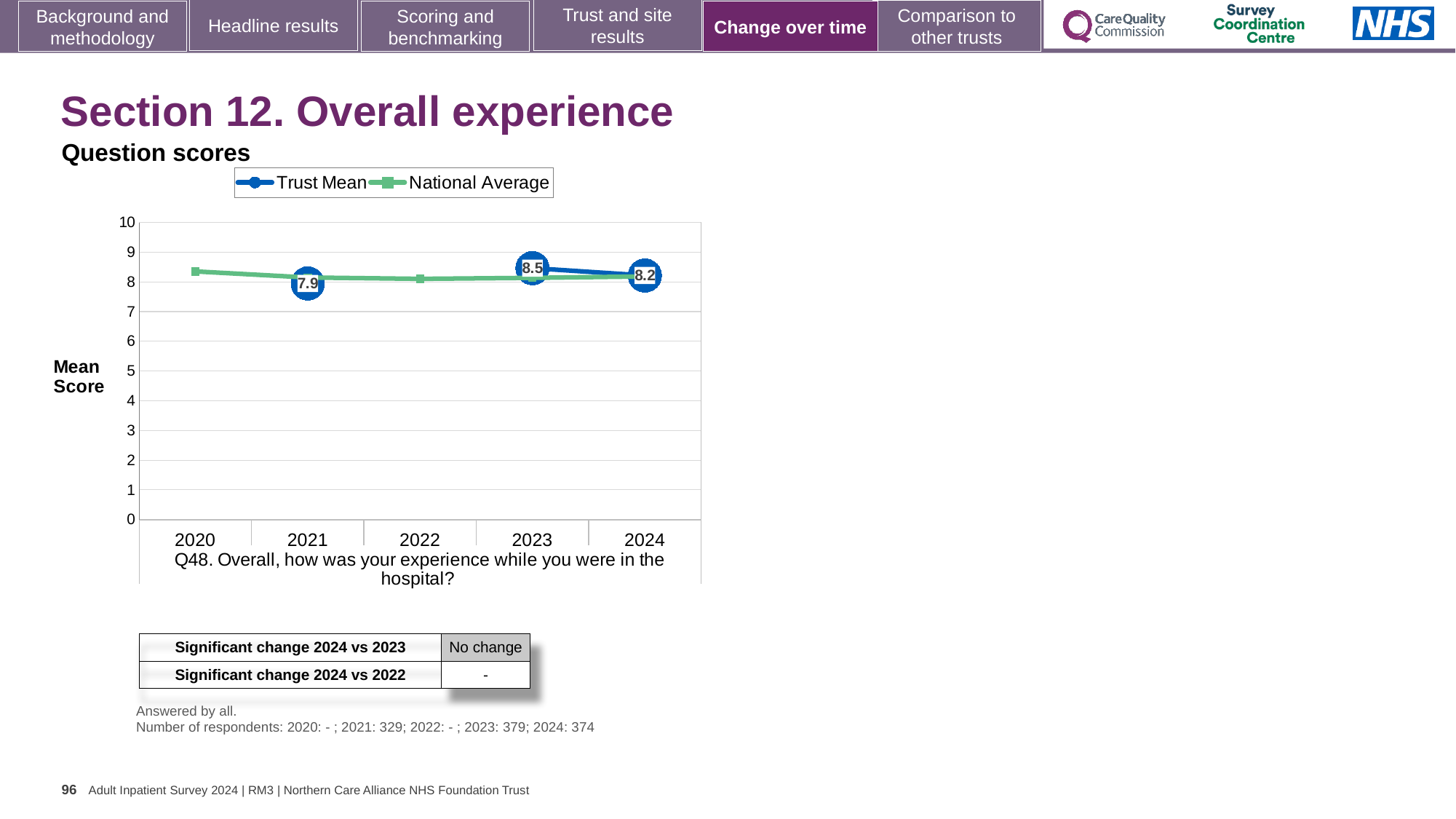
What is the Trust Mean value for 2023? 8.5 In which year is the Trust Mean lowest? 2021 What is the difference between the Trust Mean in 2023 and in 2024? 0.3 How many series does the legend list? 2 What is the Trust Mean value for 2021? 7.9 In which year is the Trust Mean highest? 2023 What is the Trust Mean value for 2024? 8.2 What kind of chart is shown on the slide? line chart How many years are shown on the x axis? 5 Is the National Average value for 2020 greater or less than 9? less What is the difference between the Trust Mean in 2023 and in 2021? 0.6 Which is larger, the Trust Mean in 2021 or in 2024? 2024